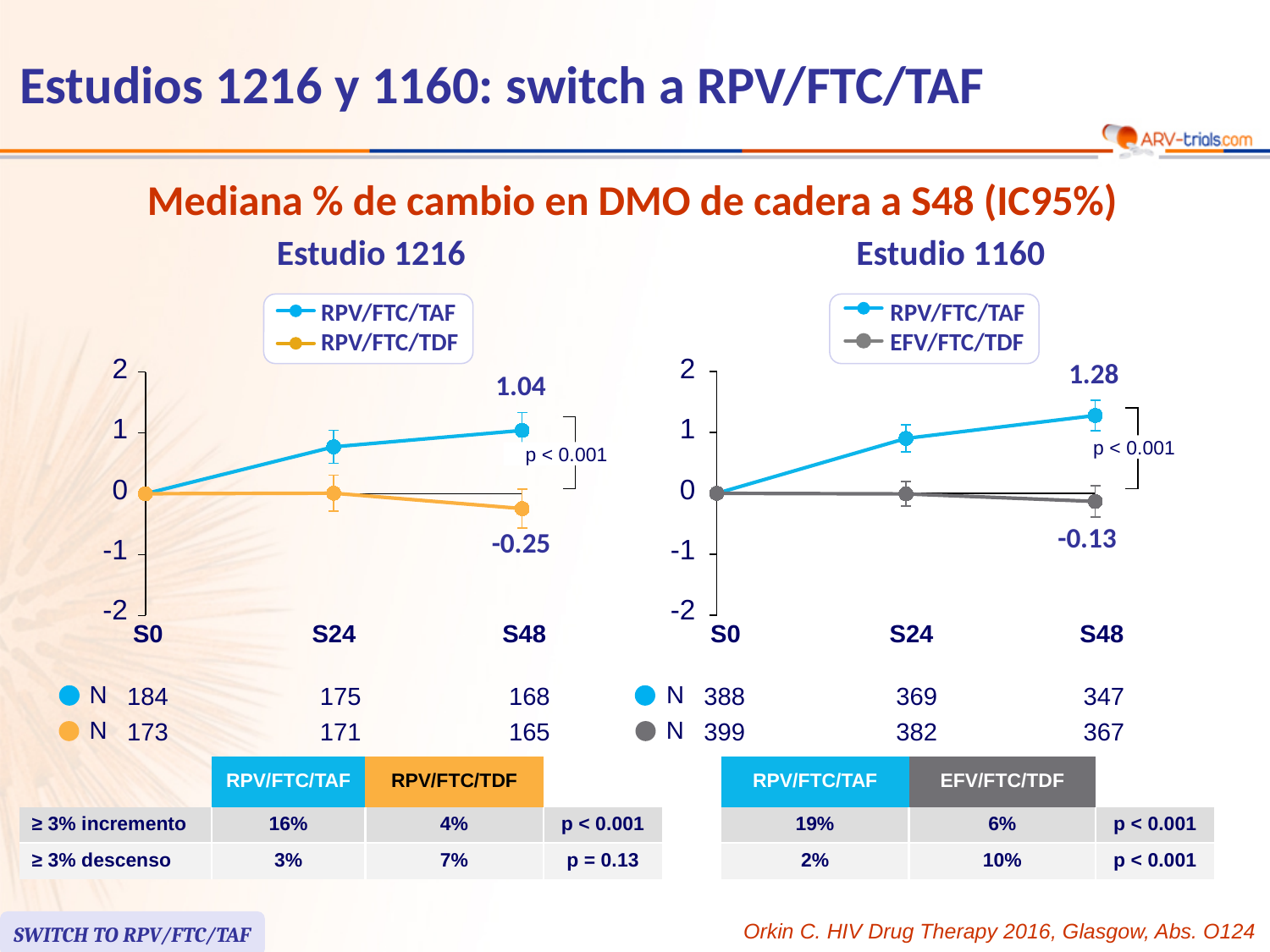
In the Estudio 1160 chart, what is the difference between the S48 values of RPV/FTC/TAF and EFV/FTC/TDF? 1.41 In the Estudio 1160 chart, what is the value for EFV/FTC/TDF at S48? -0.13 In the Estudio 1160 chart, which series has the higher value at S48, RPV/FTC/TAF or EFV/FTC/TDF? RPV/FTC/TAF In the Estudio 1160 chart, what is the value for RPV/FTC/TAF at S48? 1.28 How many time points are shown on the x axis of the Estudio 1216 chart? 3 In the Estudio 1216 chart, what is the value for RPV/FTC/TDF at S48? -0.25 In the Estudio 1216 chart, what is the difference between the S48 values of RPV/FTC/TAF and RPV/FTC/TDF? 1.29 How many series does the legend of the Estudio 1160 chart list? 2 In the Estudio 1216 chart, is the value for RPV/FTC/TAF at S24 greater or less than 1? less In the Estudio 1216 chart, what is the value for RPV/FTC/TAF at S48? 1.04 In the Estudio 1216 chart, does the RPV/FTC/TAF line rise or fall from S0 to S48? Rise What kind of chart is the Estudio 1216 chart? Line chart